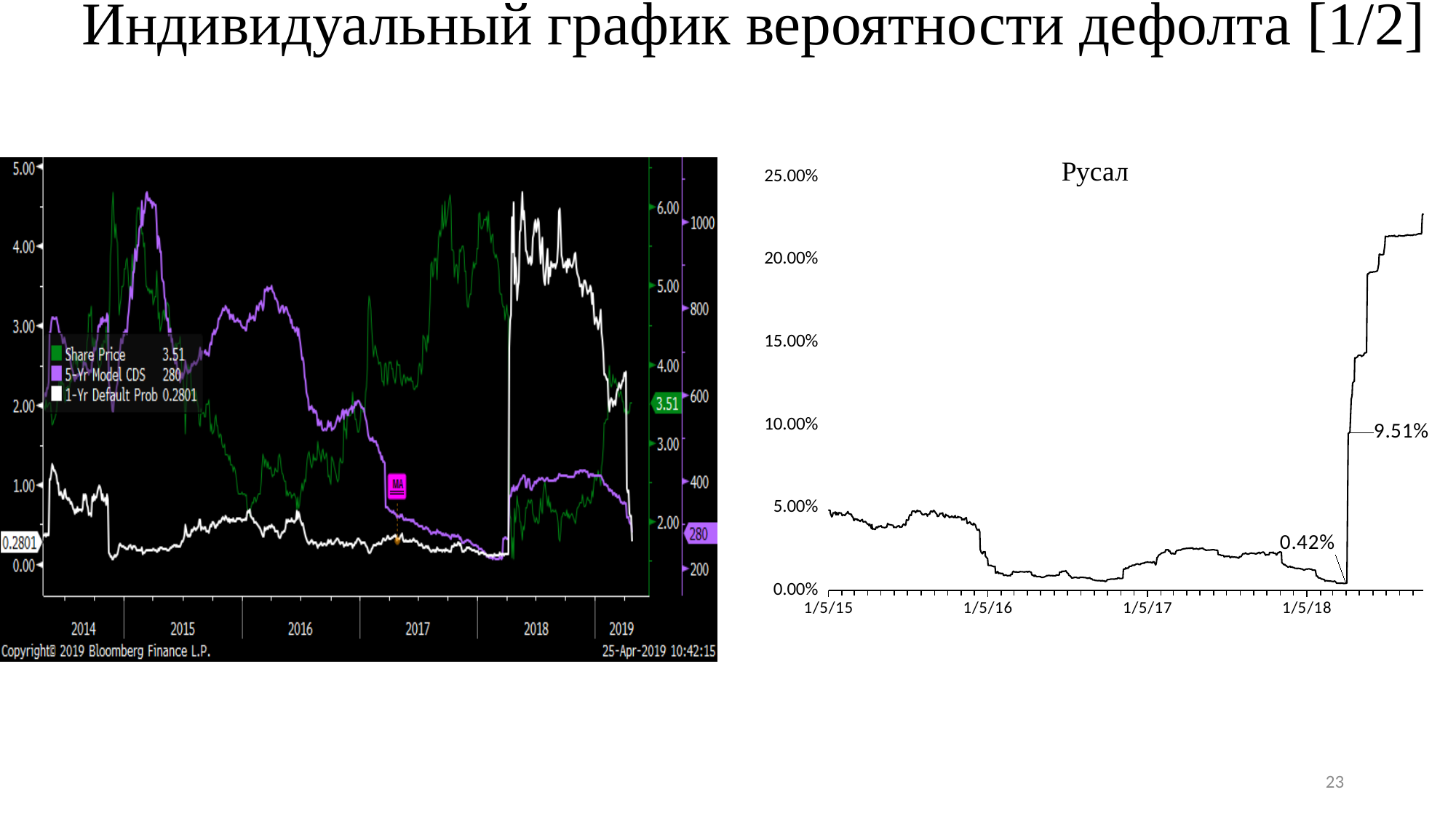
On the left Bloomberg chart, what is the latest value shown for 1-Yr Default Prob? 0.2801 On the Русал chart, is the final value at the right end of the line greater or less than 20.00%? greater On the Русал chart, is the value at 1/5/17 greater or less than 5.00%? less On the left Bloomberg chart, what is the latest value shown for 5-Yr Model CDS? 280 On the Русал chart, what value is labelled right after the sharp jump in 2018? 9.51% On the Русал chart, what is the difference between the labelled values 9.51% and 0.42%? 9.09% On the left Bloomberg chart, how many series does the legend list? 3 What kind of chart is the left Bloomberg chart? line chart On the left Bloomberg chart, what is the latest value shown for Share Price in the legend? 3.51 What is the title of the chart on the right side of the slide? Русал On the Русал chart, what value is labelled just before the sharp jump in 2018? 0.42% On the left Bloomberg chart, which colour is used for the 5-Yr Model CDS series? purple